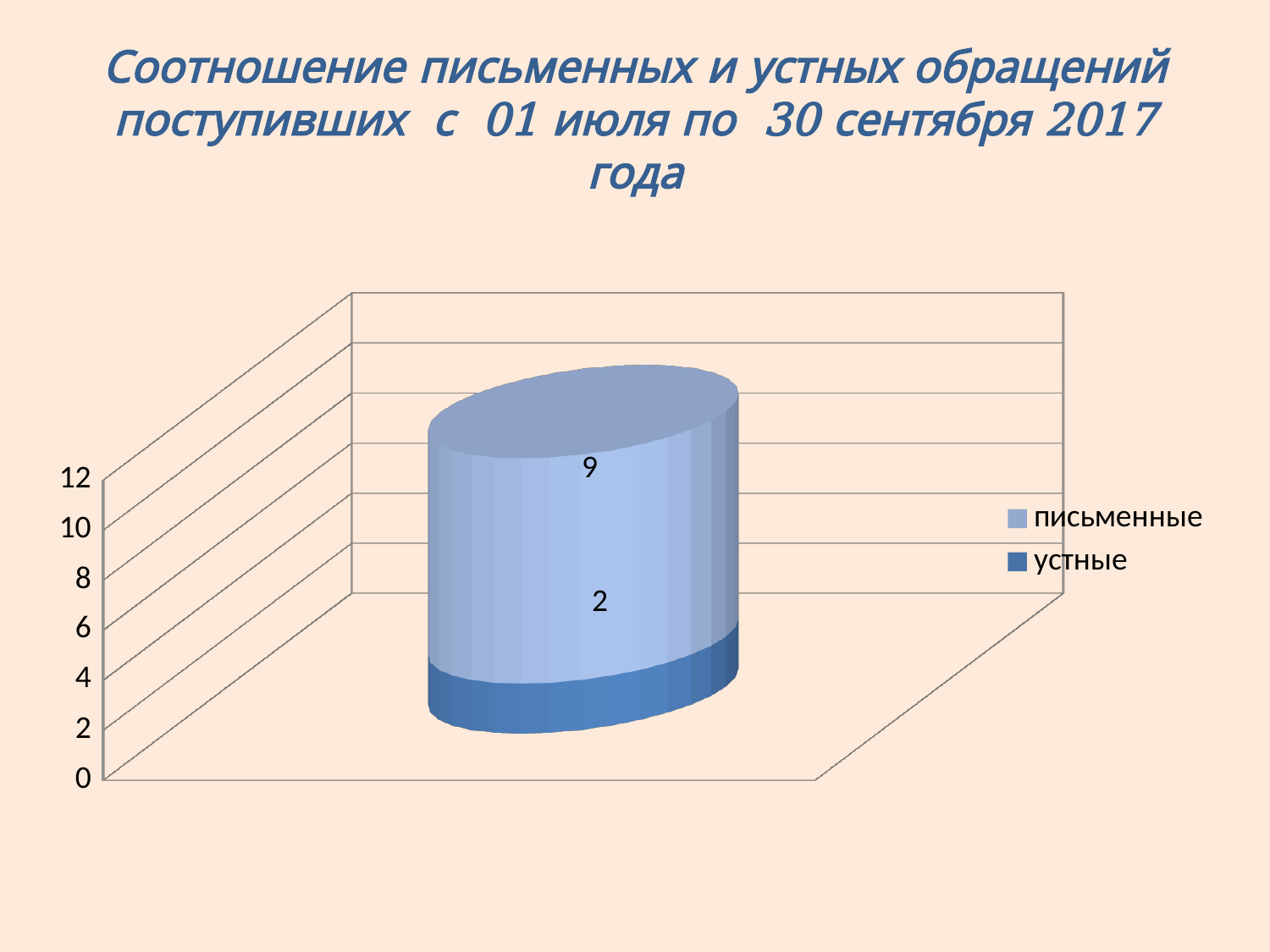
Which series has the larger value, письменные or устные? письменные Which legend entry is shown in the darker blue colour? устные What is the value for the письменные series? 9 Which series has the smallest value? устные How many series does the legend list? 2 What is the maximum value shown on the vertical axis? 12 What is the difference between the письменные value and the устные value? 7 What is the total of the stacked bar? 11 What kind of chart is shown on the slide? stacked bar chart Is the total of the stacked bar greater or less than 10? greater What is the value for the устные series? 2